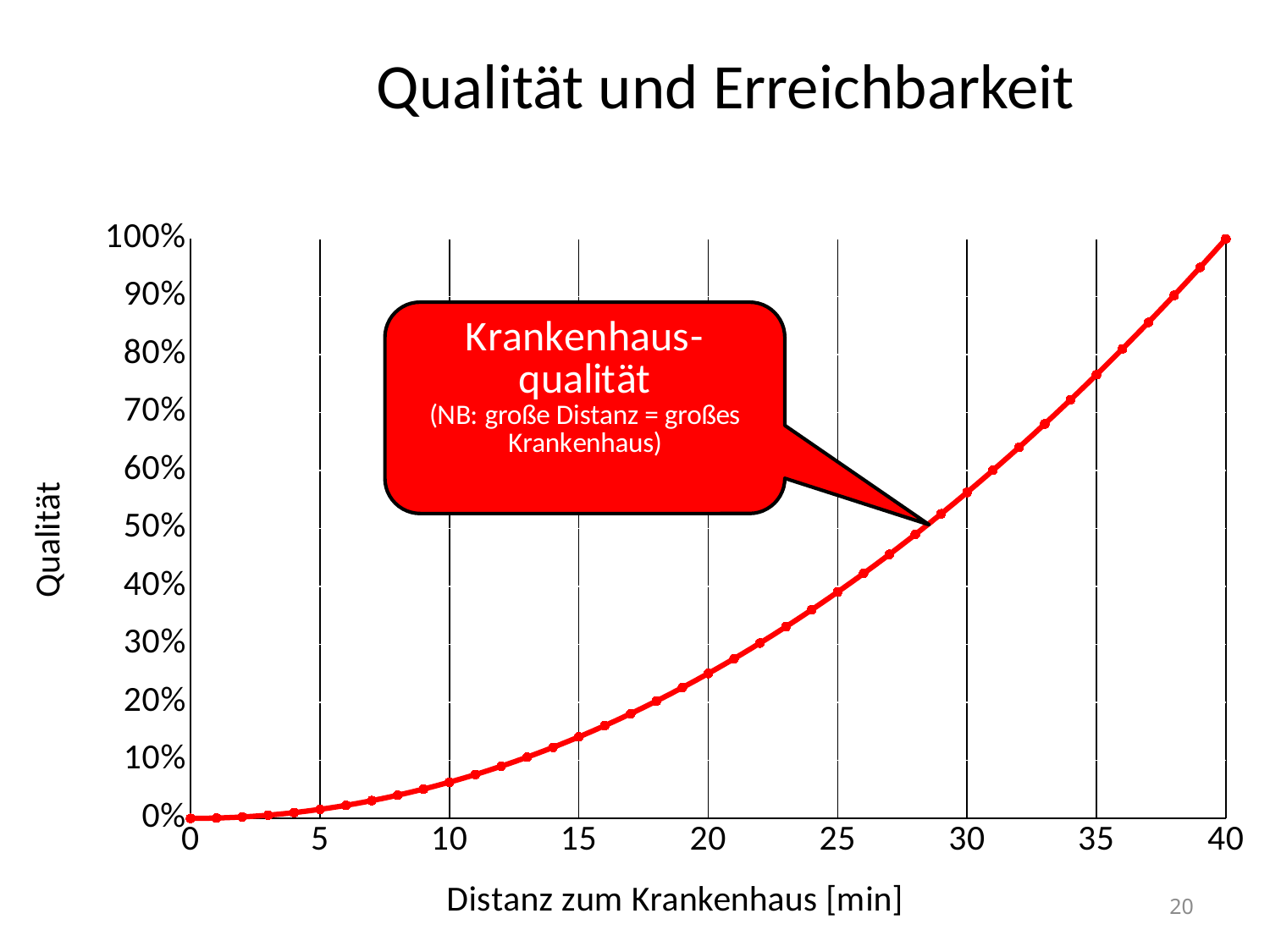
What kind of chart is shown on the slide? line chart What is the quality value at a distance of 0 min? 0% Is the quality value at 20 min greater or less than 20%? greater What is the label of the x axis? Distanz zum Krankenhaus [min] What is the label of the y axis? Qualität Is the quality value at 10 min greater or less than 10%? less At which distance does the curve reach its highest quality value? 40 At which distance does the curve have its lowest quality value? 0 Is the quality value at 20 min greater or less than 30%? less What is the quality value at a distance of 40 min? 100% Does the quality value rise or fall as the distance to the hospital increases? rise